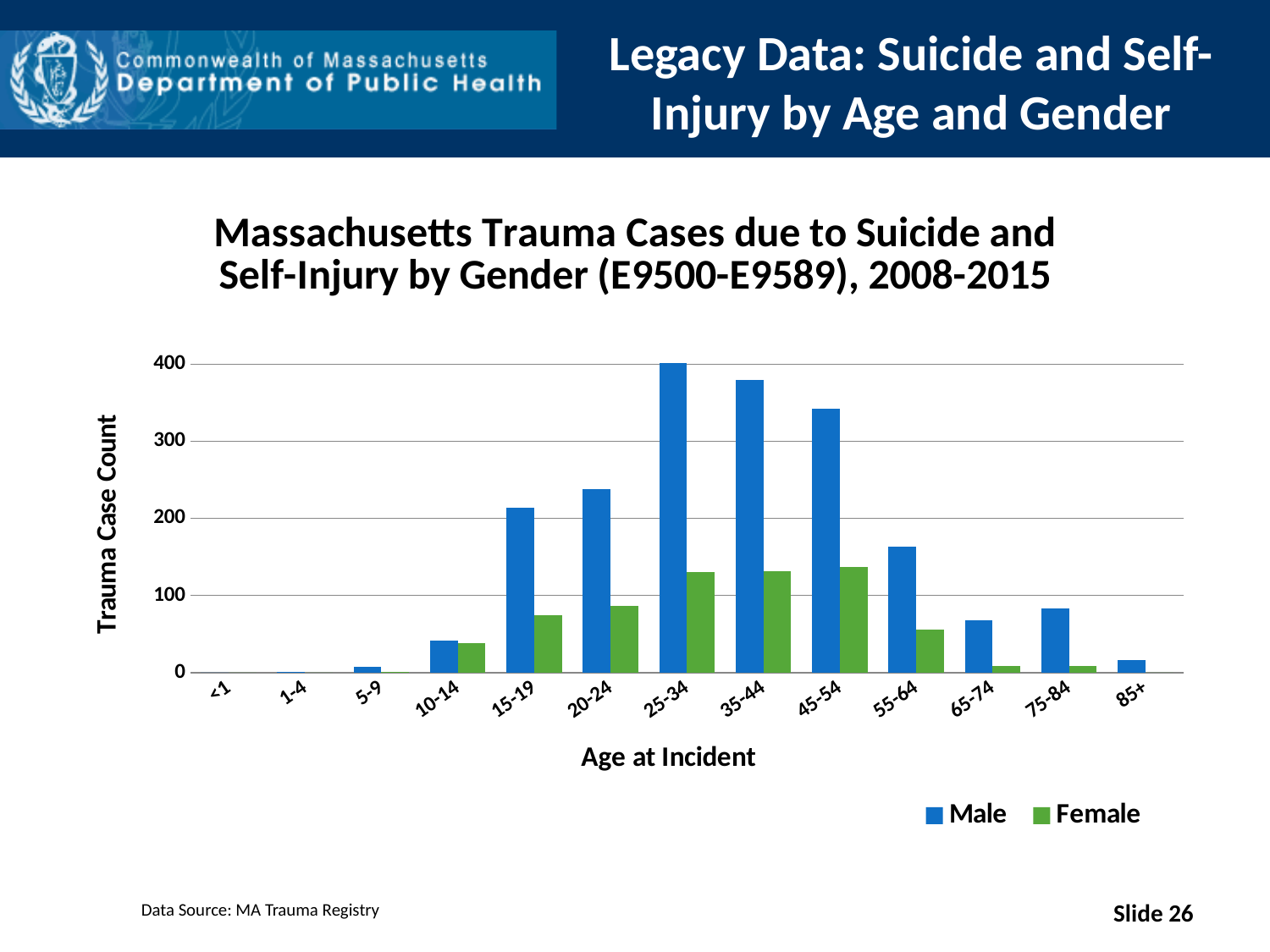
Do the Male values rise or fall from the 45-54 age group to the 85+ age group? fall Is the Female value for the 55-64 age group greater or less than 100? less Is the Female value for the 25-34 age group greater or less than 100? greater How many series does the legend list? 2 Is the Male value for the 65-74 age group greater or less than 100? less What kind of chart is shown on the slide? bar chart Which age group has the highest Male trauma case count? 25-34 How many age categories are shown on the x axis? 13 For the 25-34 age group, which is larger, the Male or the Female count? Male Which is larger, the Male count for 35-44 or the Male count for 45-54? 35-44